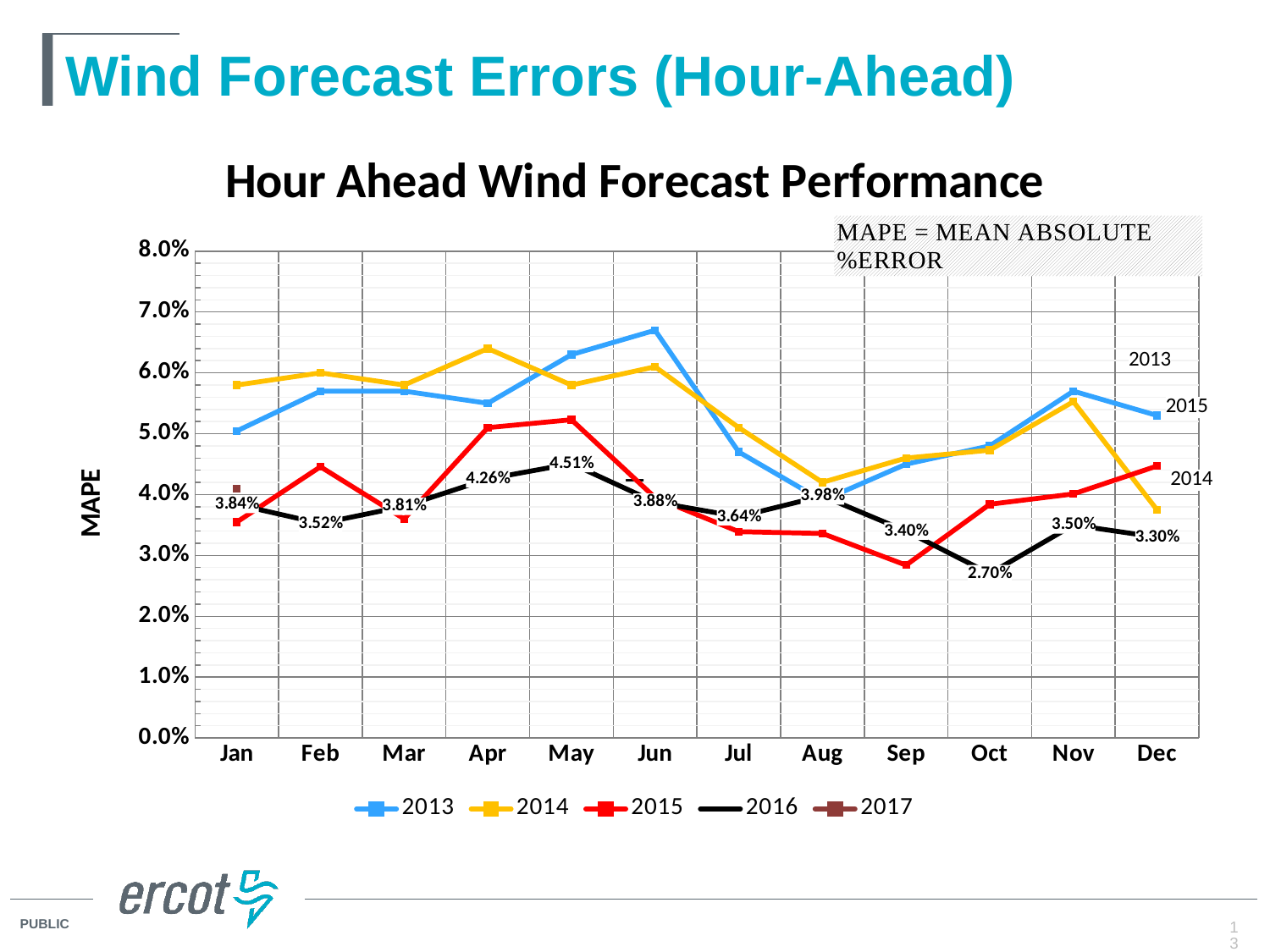
How many series does the legend list? 5 In which month is the 2016 series highest? May What is the title of the y axis? MAPE In which month is the 2016 series lowest? Oct Is the 2013 value for Jun greater or less than 6.0%? greater How many months are shown on the x axis? 12 What is the difference between the 2016 values for May and Oct? 1.81% What is the 2016 value for May? 4.51% What is the 2016 value for Oct? 2.70% Which is larger for the 2016 series, the Apr value or the Aug value? Apr Is the 2015 value for Jan greater or less than 4.0%? less What kind of chart is this? line chart